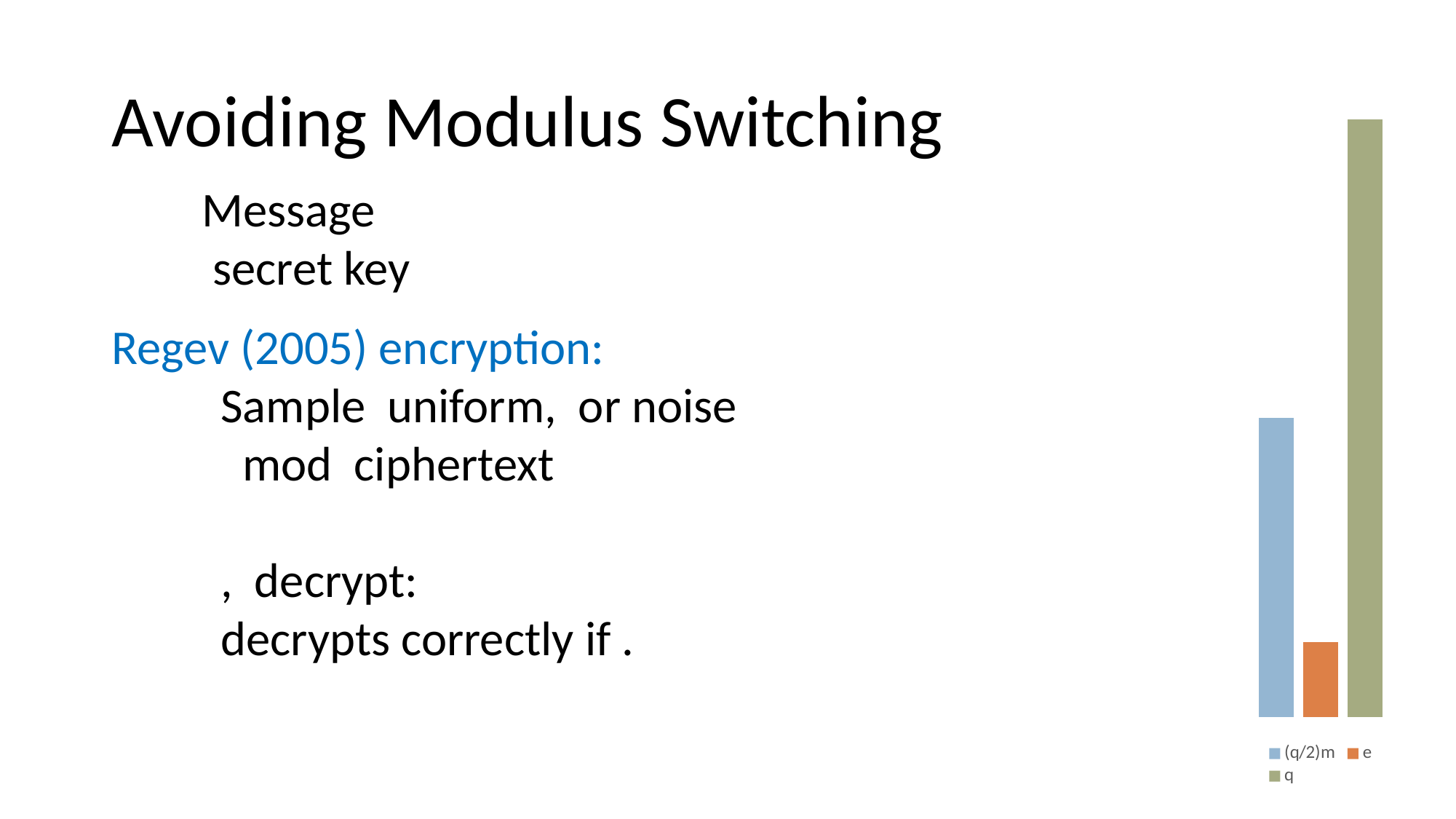
How many series does the chart's legend list? 3 What kind of chart is shown on the right side of the slide? bar chart Which bar is taller, q or (q/2)m? q Which series has the tallest bar in the chart? q Which series has the shortest bar in the chart? e How many bars are plotted in the chart? 3 What colour is the bar for the series q? green Which series is shown in orange in the chart? e Which bar is taller, (q/2)m or e? (q/2)m